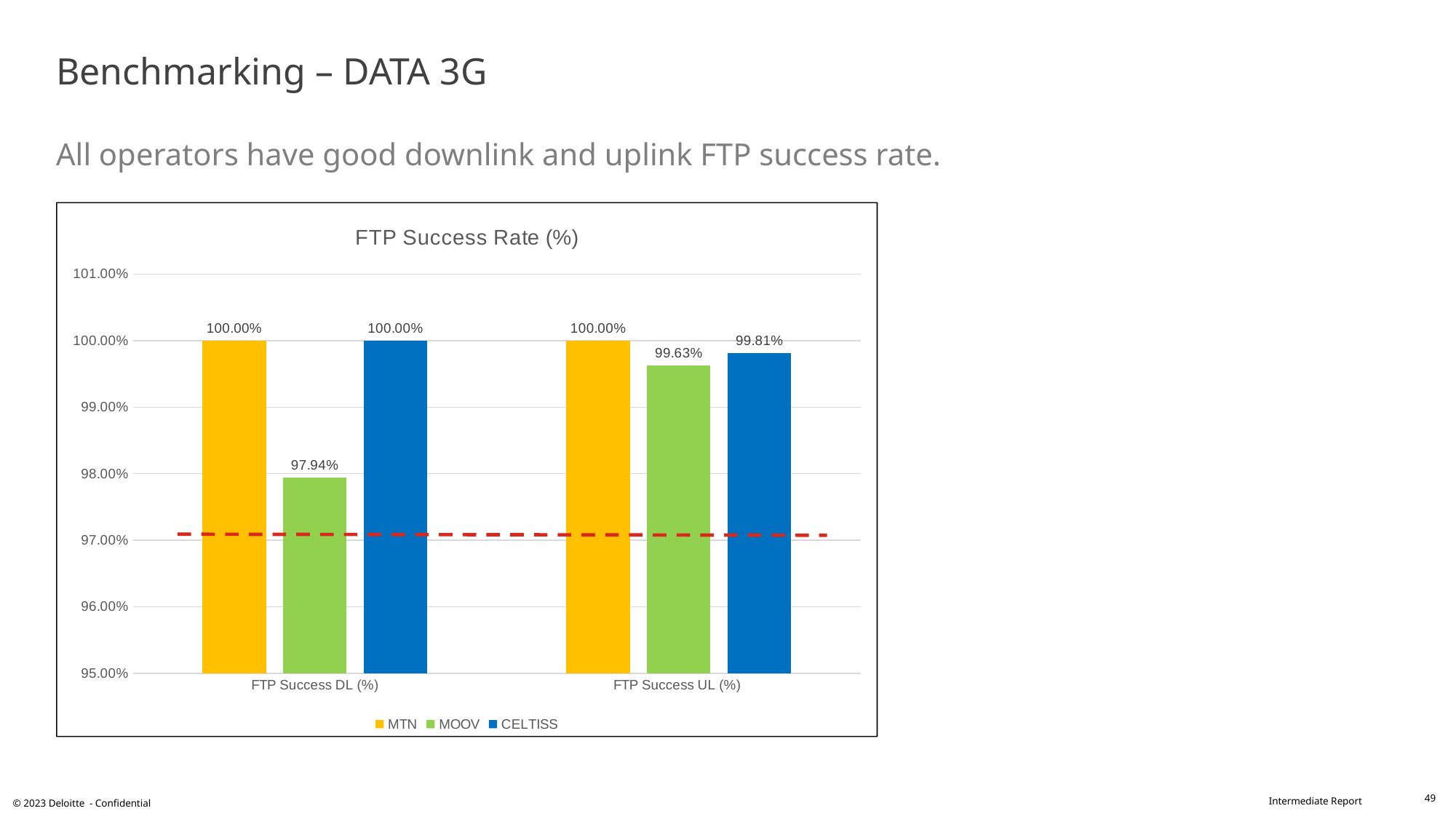
How many series does the legend list? 3 Which operator has the lowest FTP Success DL (%)? MOOV What is the difference between CELTISS's and MOOV's FTP Success UL (%) values? 0.18% What is the FTP Success DL (%) value for MOOV? 97.94% What is the FTP Success DL (%) value for MTN? 100.00% What is the title of the chart? FTP Success Rate (%) What kind of chart is shown on the slide? Bar chart Which is larger: MOOV's FTP Success DL (%) or MOOV's FTP Success UL (%)? FTP Success UL (%) What is the FTP Success UL (%) value for CELTISS? 99.81% Which operator has the lowest FTP Success UL (%)? MOOV What is the FTP Success UL (%) value for MOOV? 99.63% What is the difference between MTN's and MOOV's FTP Success DL (%) values? 2.06%